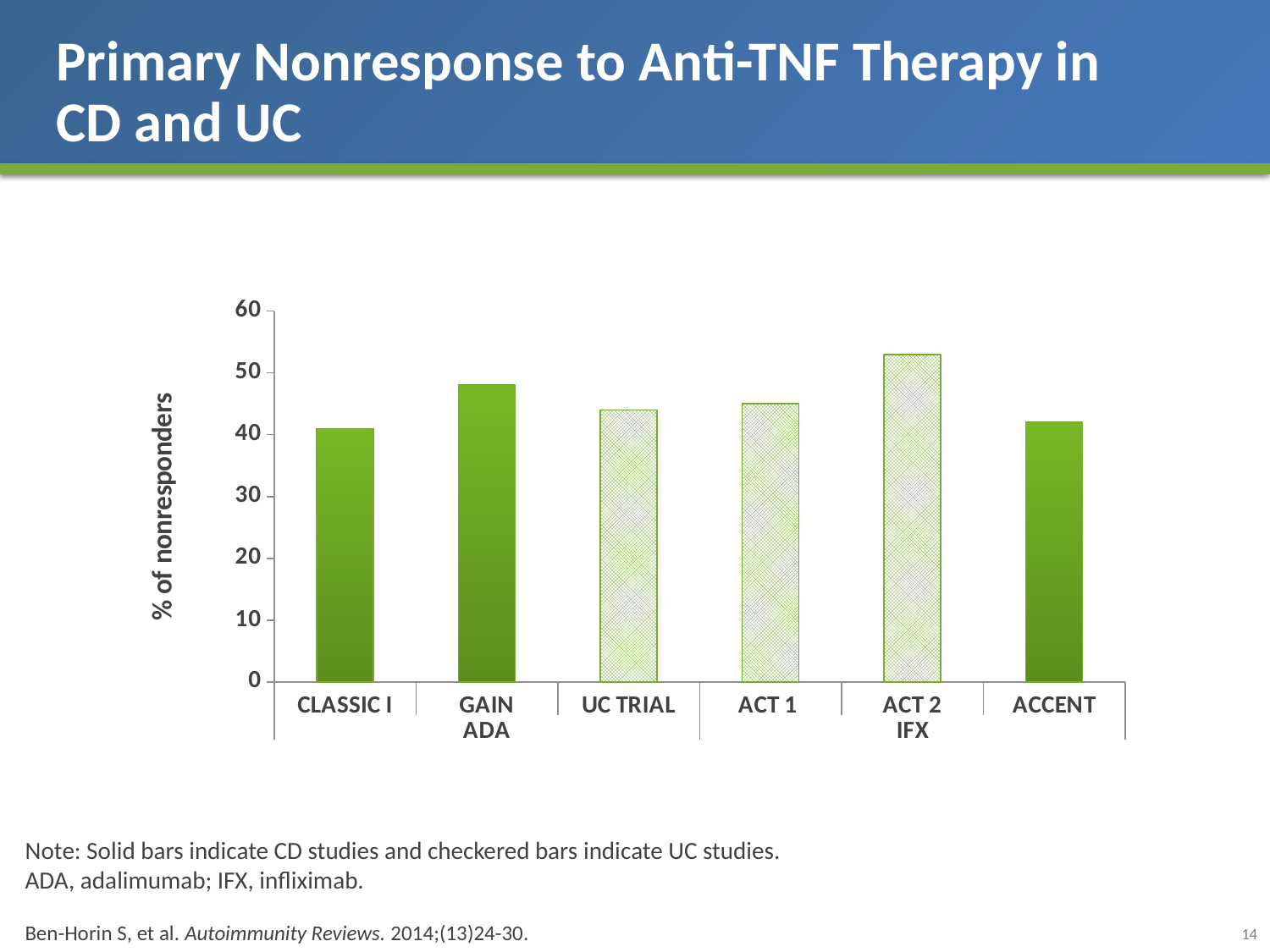
Which study has the highest % of nonresponders? ACT 2 Is the value for ACT 2 greater or less than 50? greater Is the value for ACT 1 greater or less than 40? greater What kind of chart is shown on the slide? Bar chart How many studies (bars) are shown in the chart? 6 What is the label of the y axis? % of nonresponders Which has a higher % of nonresponders, GAIN or CLASSIC I? GAIN Is the value for ACCENT greater or less than 30? greater According to the note, what do the checkered bars indicate? UC studies Which has a higher % of nonresponders, ACT 2 or UC TRIAL? ACT 2